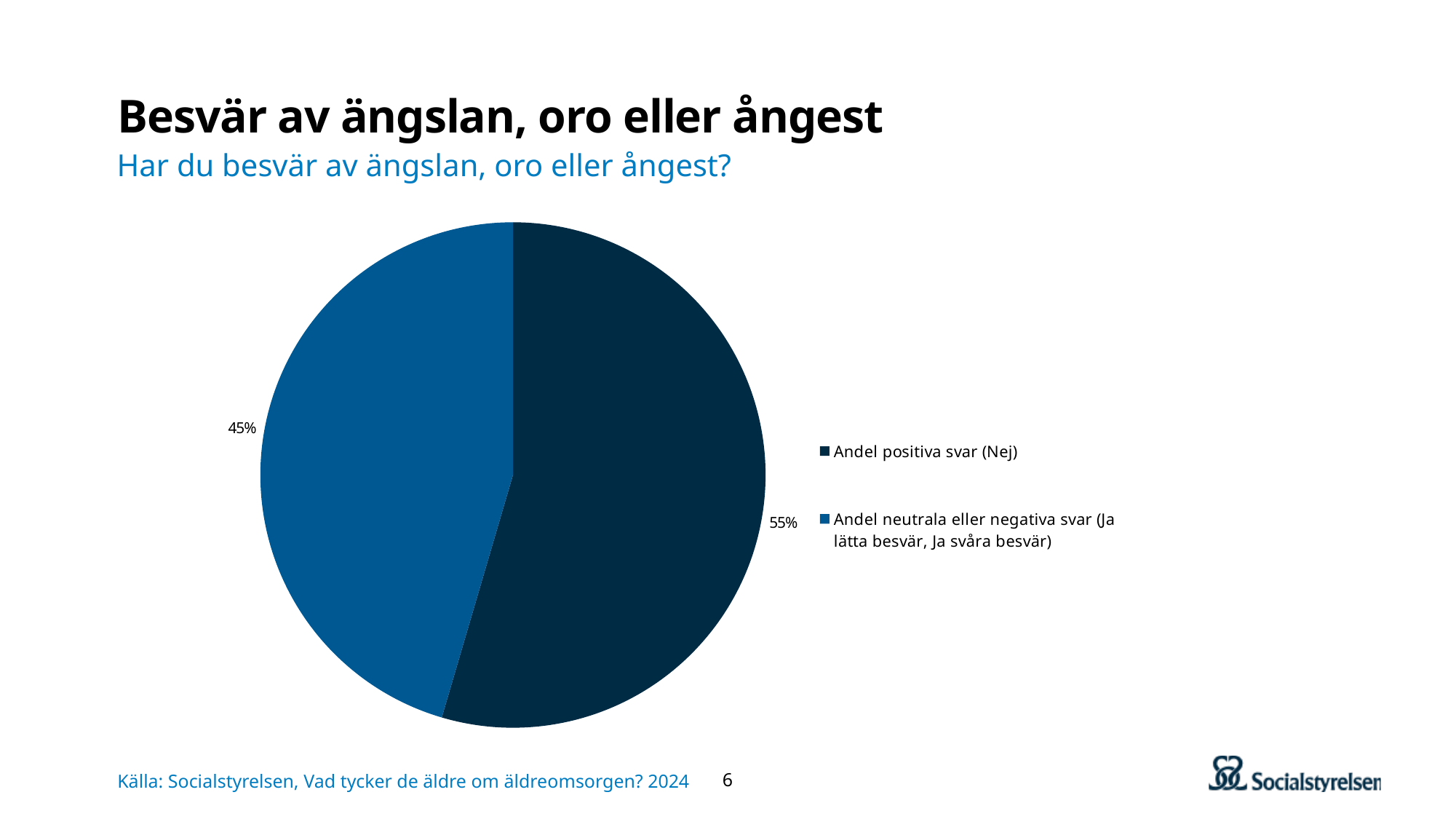
How many slices does the pie chart have? 2 Which slice of the pie is the largest? Andel positiva svar (Nej) What is the difference in percentage points between the 'Andel positiva svar (Nej)' slice and the 'Andel neutrala eller negativa svar' slice? 10 percentage points How many entries does the legend list? 2 What share of the pie is 'Andel positiva svar (Nej)'? 55% What share of the pie is 'Andel neutrala eller negativa svar (Ja lätta besvär, Ja svåra besvär)'? 45% Is the share for 'Andel positiva svar (Nej)' greater or less than 50%? greater Which is larger: the share for 'Andel positiva svar (Nej)' or the share for 'Andel neutrala eller negativa svar'? Andel positiva svar (Nej) Which legend entry is shown in the darker navy colour? Andel positiva svar (Nej) What question is shown as the subtitle above the chart? Har du besvär av ängslan, oro eller ångest? What kind of chart is shown on the slide? pie chart Which slice of the pie is the smallest? Andel neutrala eller negativa svar (Ja lätta besvär, Ja svåra besvär)